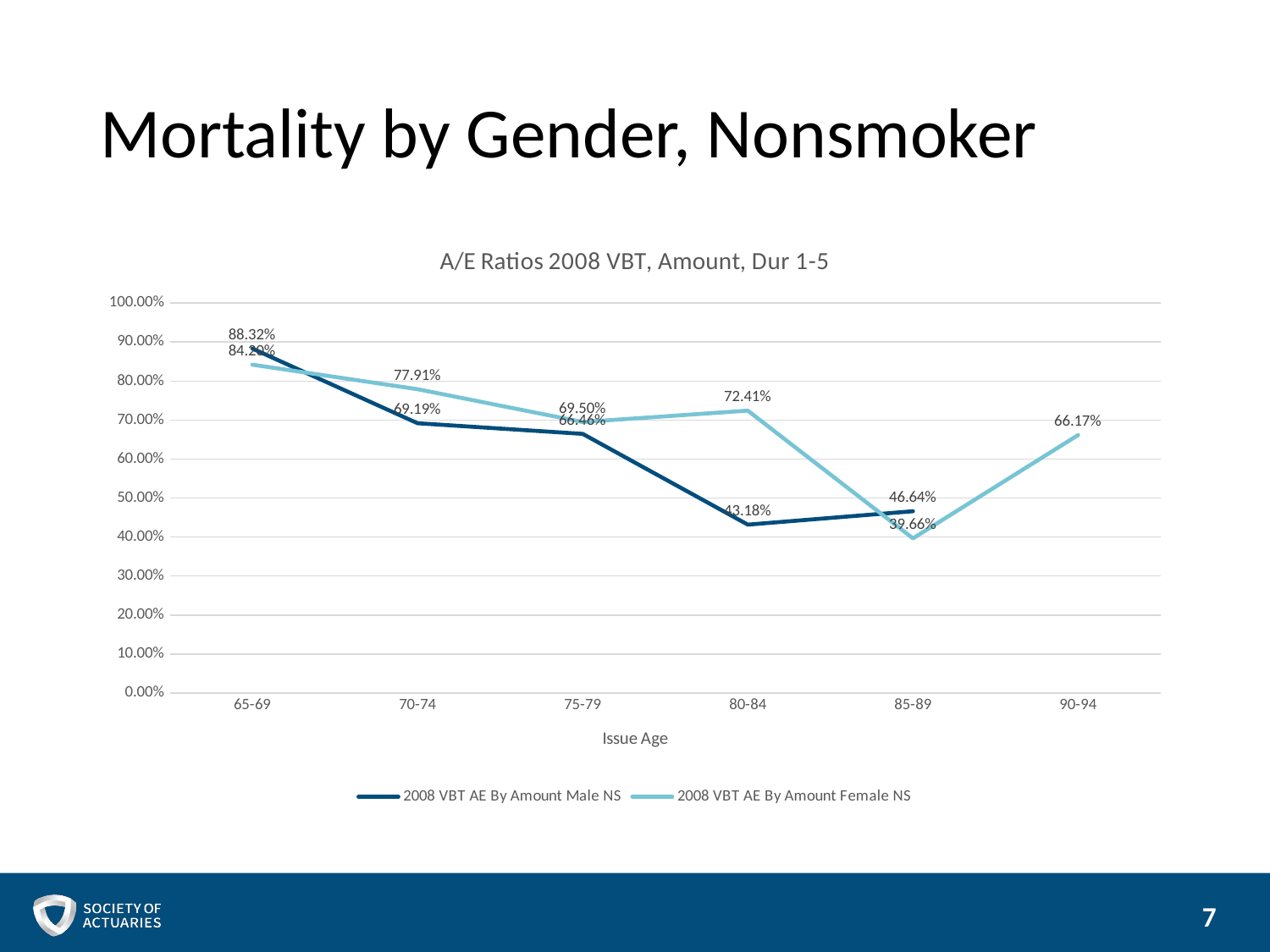
What is the 2008 VBT AE By Amount Female NS value for issue age 90-94? 66.17% What is the title of the x axis? Issue Age What kind of chart is shown on the slide? Line chart At issue age 85-89, which series has the larger value, Male NS or Female NS? Male NS For which issue age group is the Female NS A/E ratio lowest? 85-89 How many series does the legend list? 2 For which issue age group is the Male NS A/E ratio highest? 65-69 What is the 2008 VBT AE By Amount Male NS value for issue age 70-74? 69.19% How many issue age groups are shown on the x axis? 6 What is the 2008 VBT AE By Amount Male NS value for issue age 80-84? 43.18% At issue age 70-74, how much higher is the Female NS ratio than the Male NS ratio? 8.72 percentage points What is the 2008 VBT AE By Amount Female NS value for issue age 80-84? 72.41%